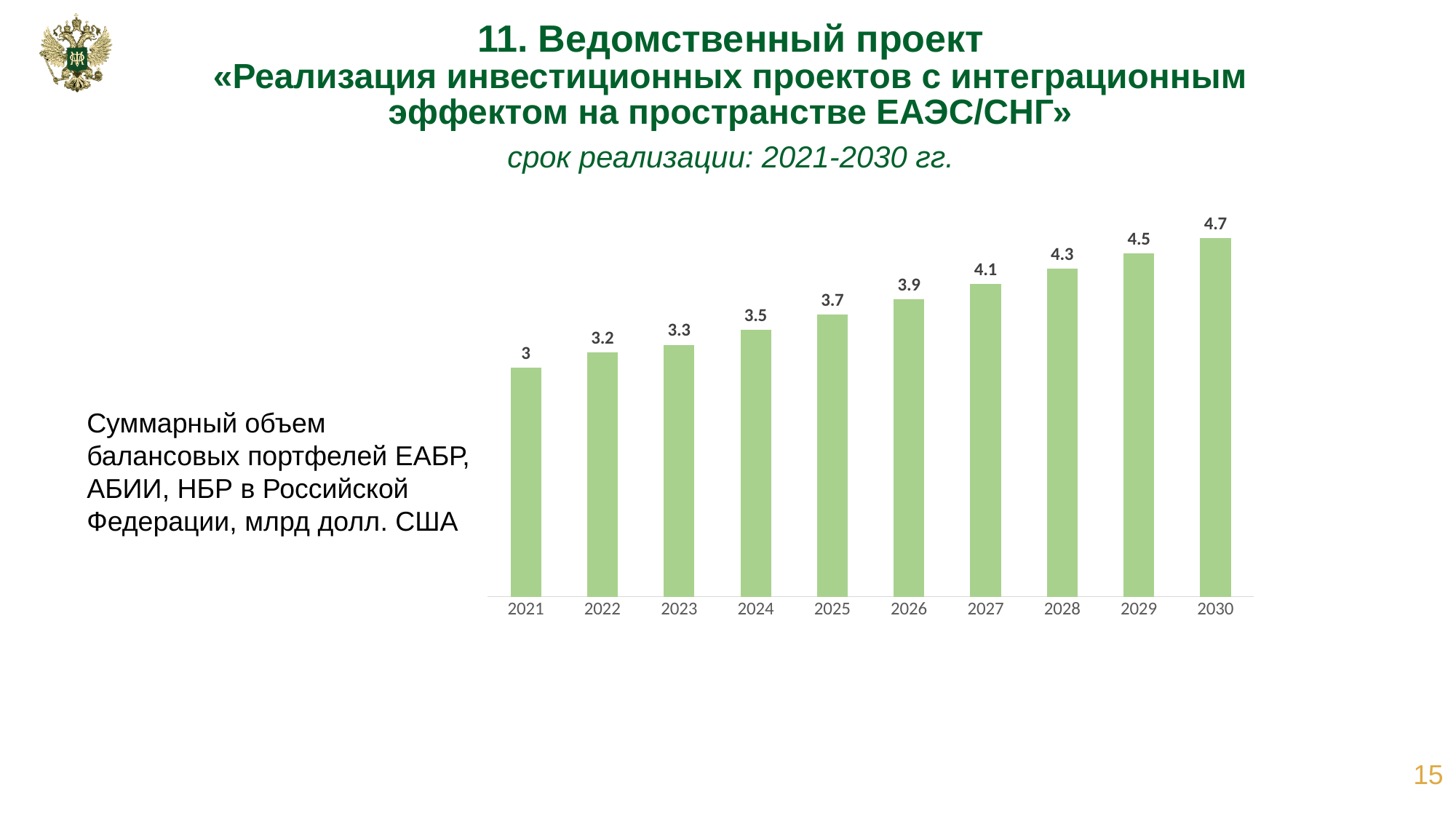
Which year has the highest value? 2030 How many years are shown on the x axis? 10 What is the value for 2025? 3.7 What kind of chart is this? bar chart What is the value for 2030? 4.7 What is the difference between the values for 2026 and 2024? 0.4 What is the value for 2021? 3 Do the values rise or fall from 2021 to 2030? rise Which is larger, the value for 2023 or the value for 2028? 2028 What colour are the bars? green Which year has the lowest value? 2021 What is the difference between the values for 2030 and 2021? 1.7